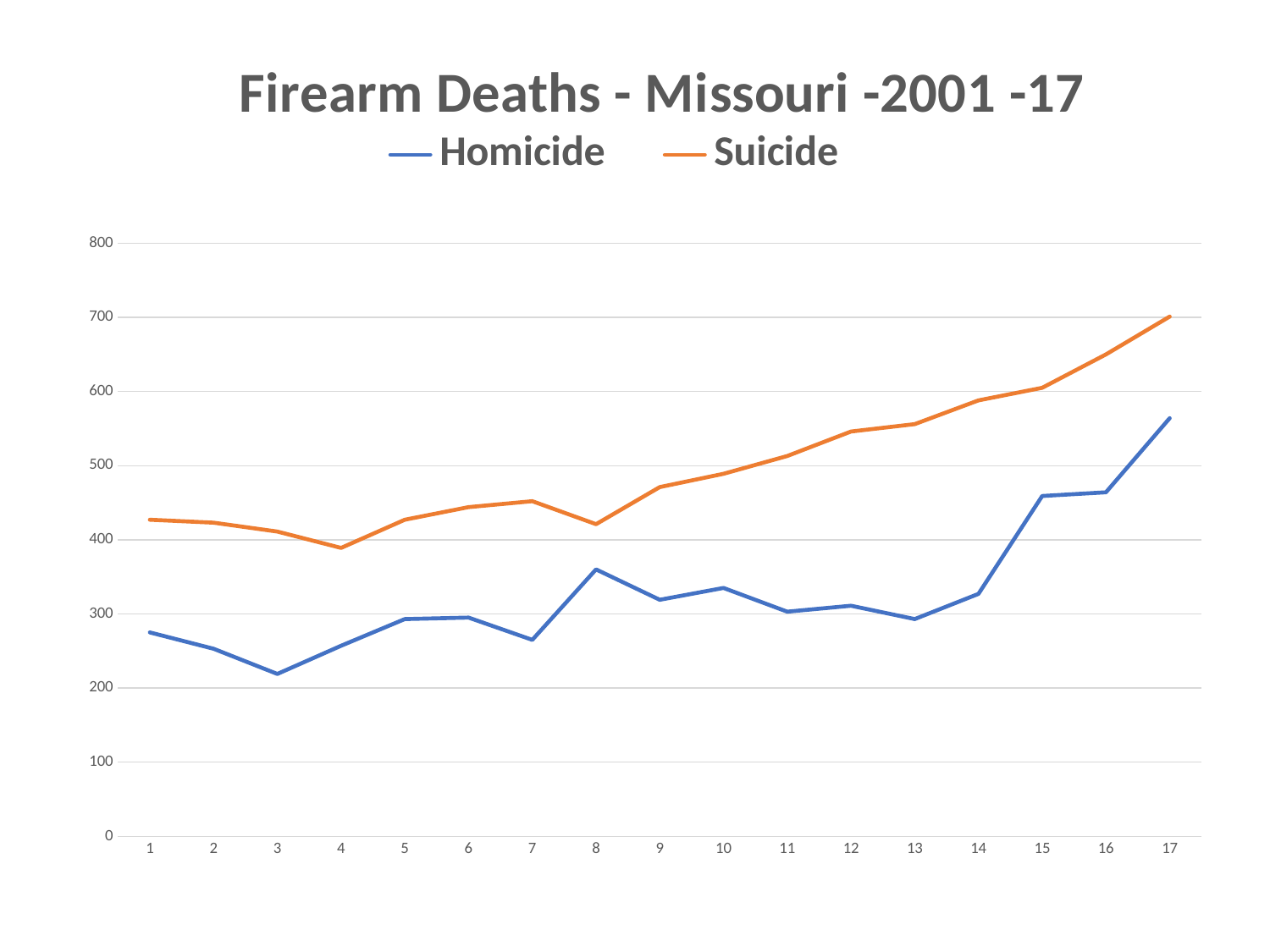
How many series does the legend list? 2 How many points are plotted along the x axis for each series? 17 Is the Suicide value at point 4 greater or less than 300? greater Which series has the higher value at point 10, Homicide or Suicide? Suicide What is the title of the chart? Firearm Deaths - Missouri -2001 -17 Which series is drawn in orange? Suicide Does the Suicide series generally rise or fall from point 8 to point 17? rise Is the Homicide value at point 3 greater or less than 300? less At which point does the Suicide series reach its highest value? 17 What kind of chart is shown on the slide? line chart Is the Suicide value at point 17 greater or less than 600? greater